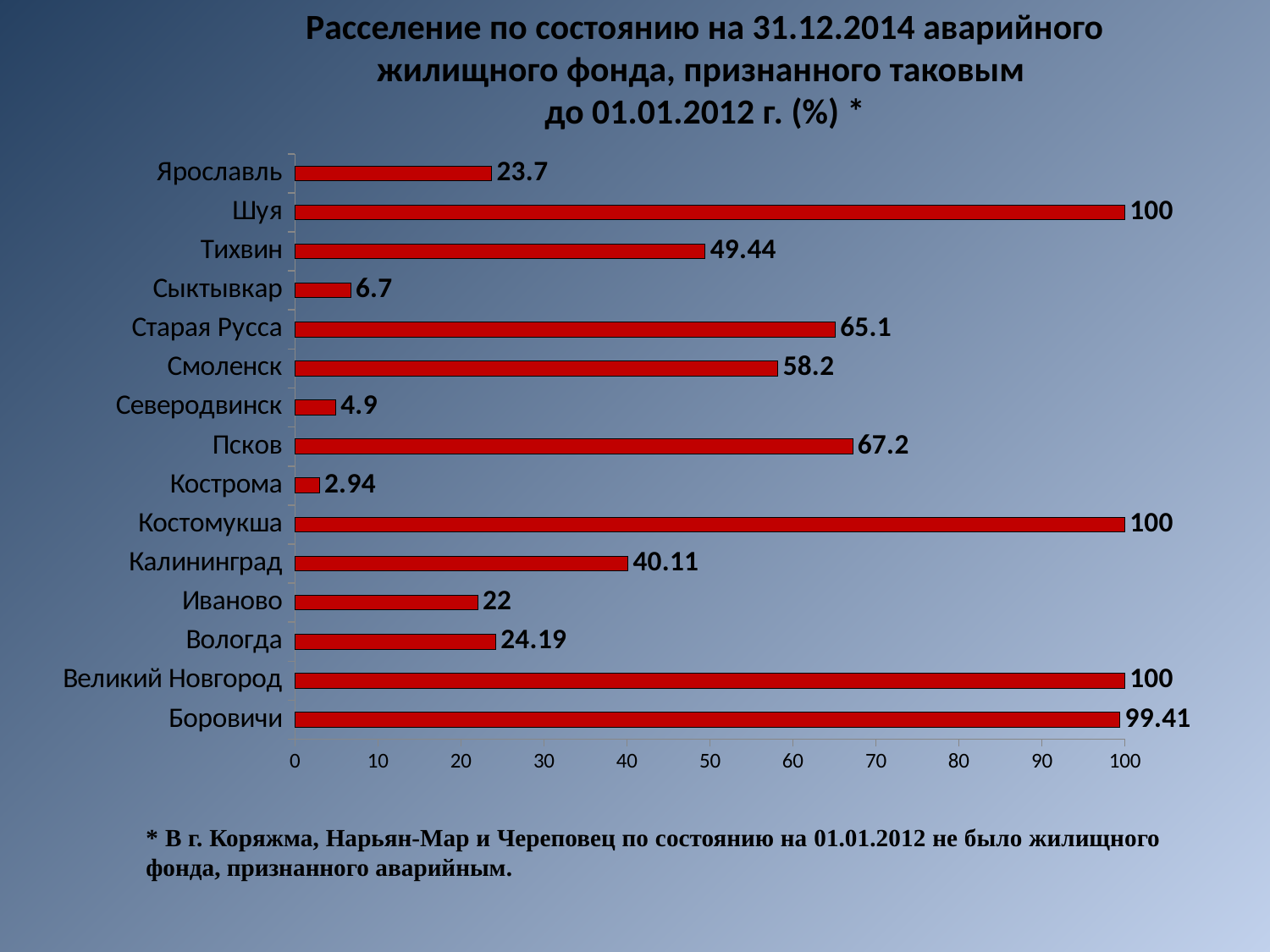
What colour are the bars in the chart? red What is the difference between the values for Псков and Смоленск? 9 Which cities have the highest value of 100? Шуя, Костомукша, Великий Новгород How many cities are shown in the chart? 15 What is the difference between the values for Старая Русса and Ярославль? 41.4 What is the value for Тихвин? 49.44 What is the value for Северодвинск? 4.9 What is the value for Калининград? 40.11 What is the value for Боровичи? 99.41 Which city has the lowest value? Кострома What type of chart is shown on the slide? bar chart Which is larger, the value for Вологда or the value for Иваново? Вологда